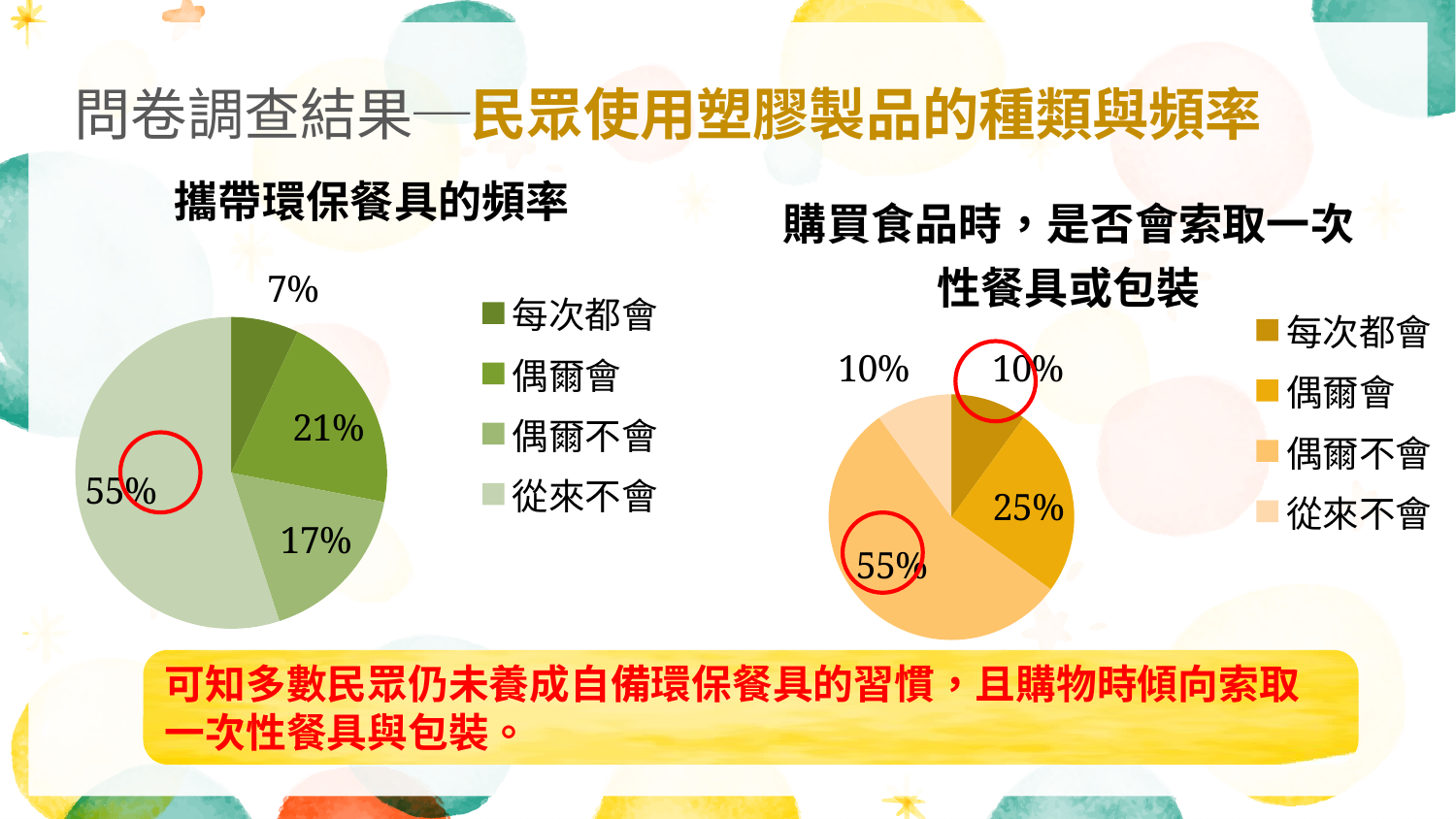
What type of chart is the chart titled 攜帶環保餐具的頻率? pie chart In the chart titled 購買食品時，是否會索取一次性餐具或包裝, what percentage is shown for 偶爾會? 25% In the chart titled 購買食品時，是否會索取一次性餐具或包裝, which category has the largest share? 偶爾不會 In the chart titled 攜帶環保餐具的頻率, what percentage is shown for 每次都會? 7% In the chart titled 攜帶環保餐具的頻率, what percentage is shown for 從來不會? 55% In the chart titled 攜帶環保餐具的頻率, what is the difference between the shares of 偶爾會 and 偶爾不會? 4% In the chart titled 購買食品時，是否會索取一次性餐具或包裝, what percentage is shown for 偶爾不會? 55% In the chart titled 購買食品時，是否會索取一次性餐具或包裝, which is larger, the share for 偶爾會 or the share for 每次都會? 偶爾會 How many categories does the legend of the chart titled 購買食品時，是否會索取一次性餐具或包裝 list? 4 How many charts are shown on the slide? 2 In the chart titled 攜帶環保餐具的頻率, which category has the smallest share? 每次都會 In the chart titled 攜帶環保餐具的頻率, which category has the largest share? 從來不會